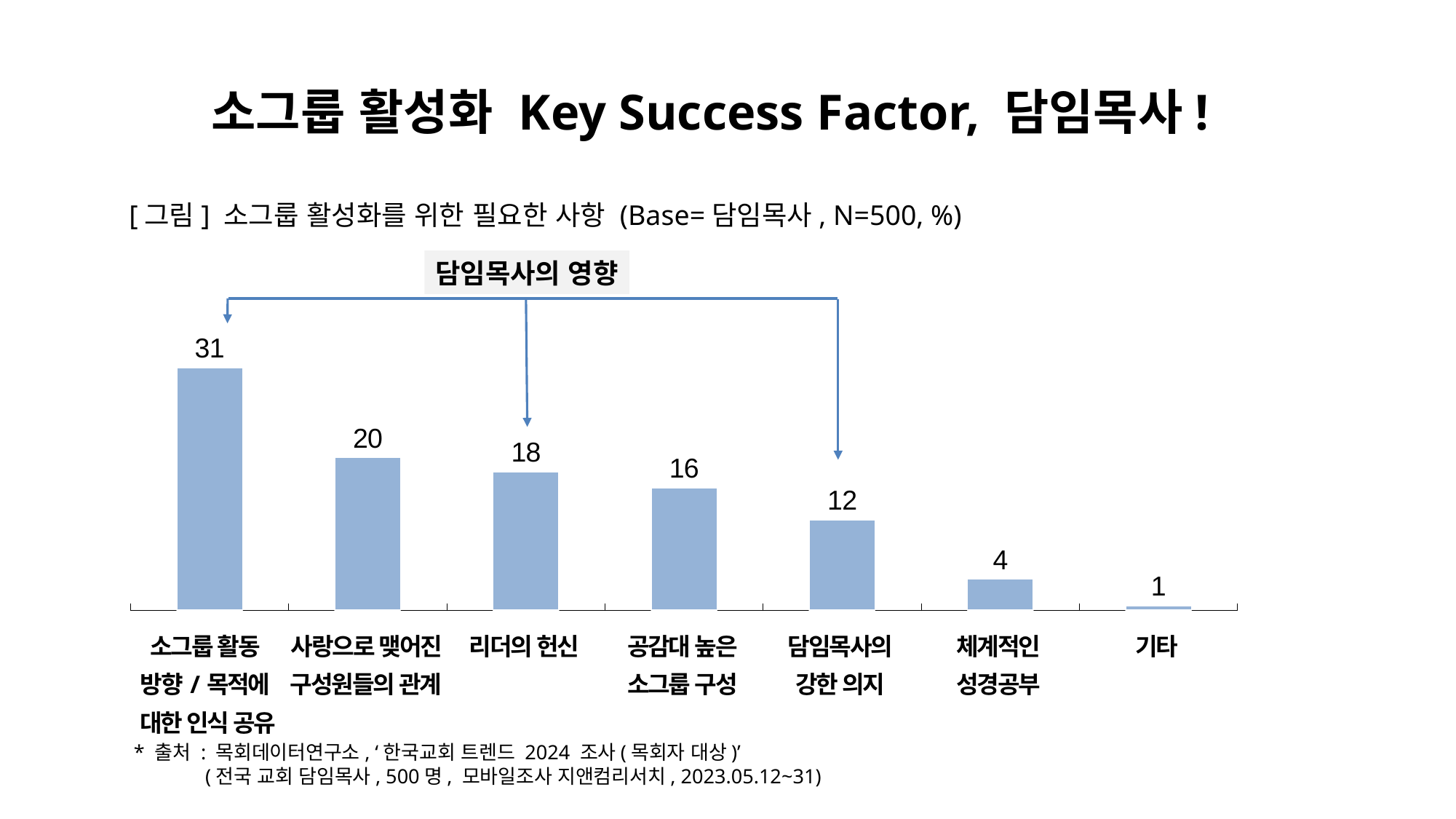
What kind of chart is shown on the slide? Bar chart What is the value for 체계적인 성경공부? 4 What is the value for 담임목사의 강한 의지? 12 Which is larger, the value for 리더의 헌신 or the value for 담임목사의 강한 의지? 리더의 헌신 What is the text in the box above the arrows pointing to three of the bars? 담임목사의 영향 Do the values rise or fall from left to right along the x axis? Fall What is the difference between the values for 사랑으로 맺어진 구성원들의 관계 and 공감대 높은 소그룹 구성? 4 What is the value for 리더의 헌신? 18 What is the value for 소그룹 활동 방향 / 목적에 대한 인식 공유? 31 Which category has the highest value? 소그룹 활동 방향 / 목적에 대한 인식 공유 Which category has the lowest value? 기타 How many categories are shown in the chart? 7